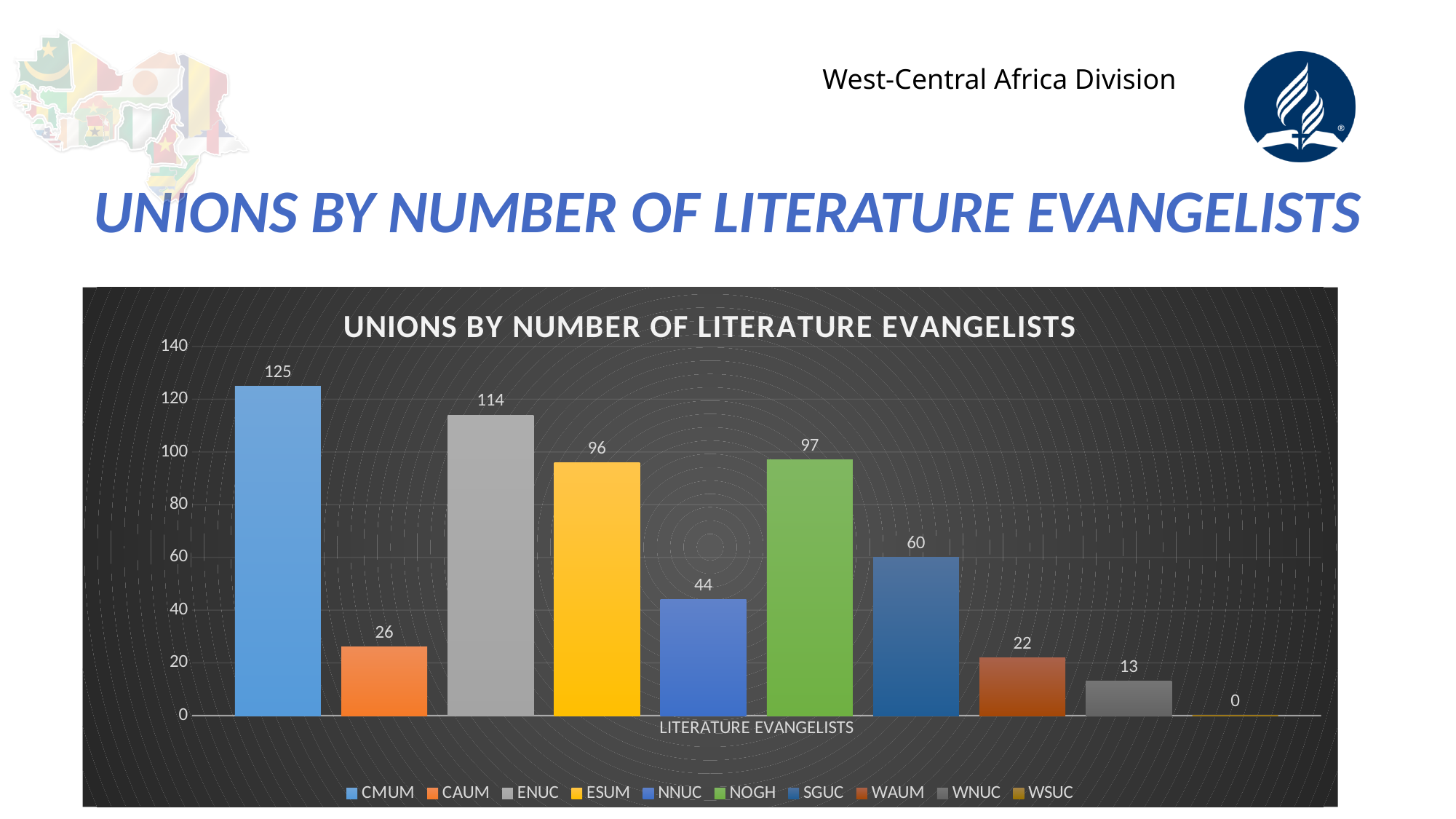
Which union has the highest number of literature evangelists? CMUM What is the number of literature evangelists for CMUM? 125 What is the number of literature evangelists for NOGH? 97 What kind of chart is shown on the slide? bar chart What is the difference between the number of literature evangelists for CMUM and ENUC? 11 What is the title of the chart? UNIONS BY NUMBER OF LITERATURE EVANGELISTS Is the value for NNUC greater or less than 60? less How many unions are shown in the chart? 10 Which has more literature evangelists, ESUM or SGUC? ESUM Which union has the lowest number of literature evangelists? WSUC How many entries does the legend list? 10 What is the number of literature evangelists for WAUM? 22